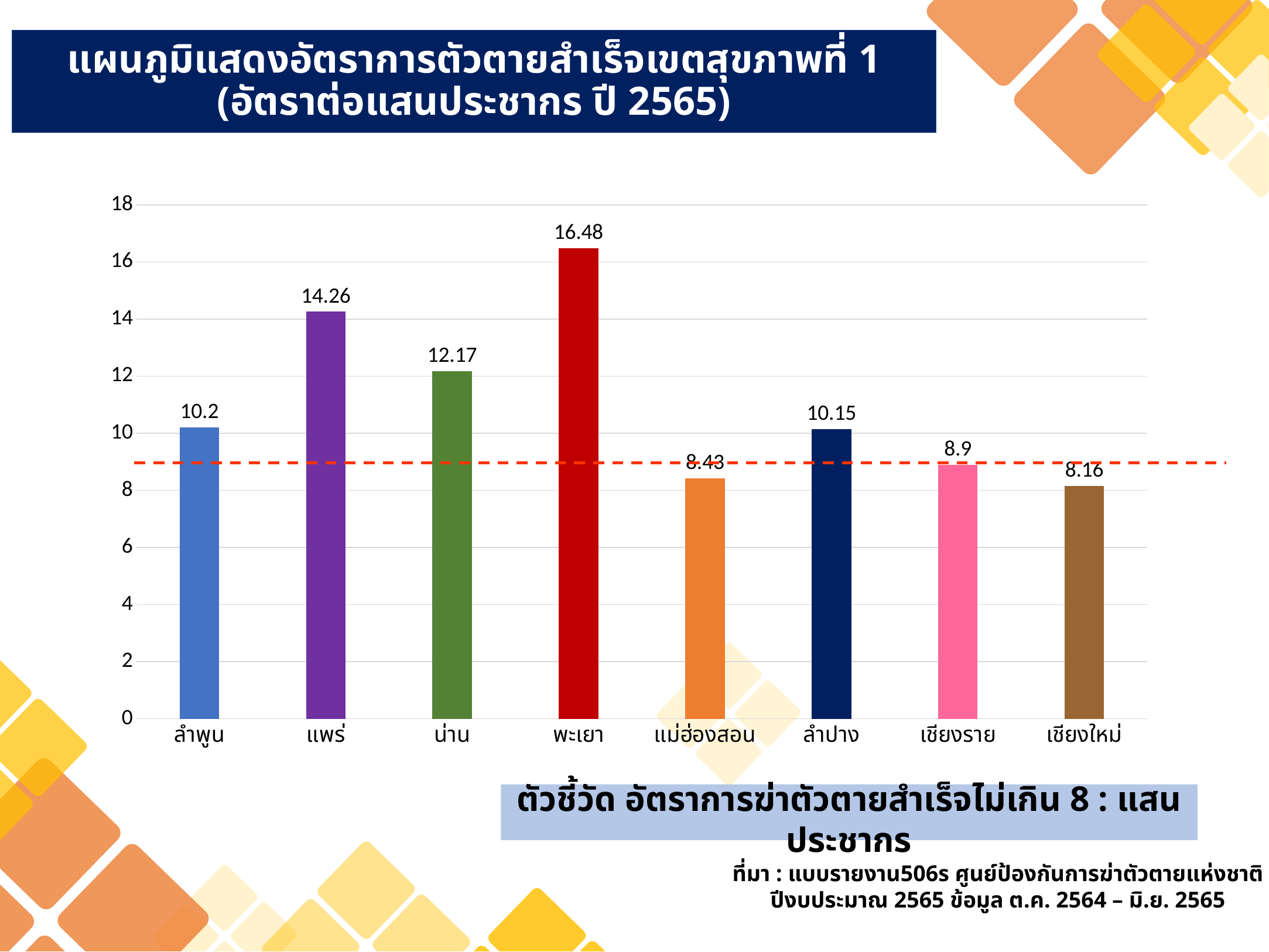
What kind of chart is shown on the slide? bar chart What is the value for พะเยา? 16.48 Which is larger, the value for น่าน or the value for ลำพูน? น่าน Is the value for เชียงราย greater or less than 10? less Which province has the lowest value? เชียงใหม่ What is the difference between the values for ลำพูน and ลำปาง? 0.05 How many provinces are shown on the x axis? 8 What colour is the bar for พะเยา? red What is the value for แม่ฮ่องสอน? 8.43 Which province has the highest value? พะเยา What is the value for ลำปาง? 10.15 What is the difference between the values for พะเยา and แพร่? 2.22